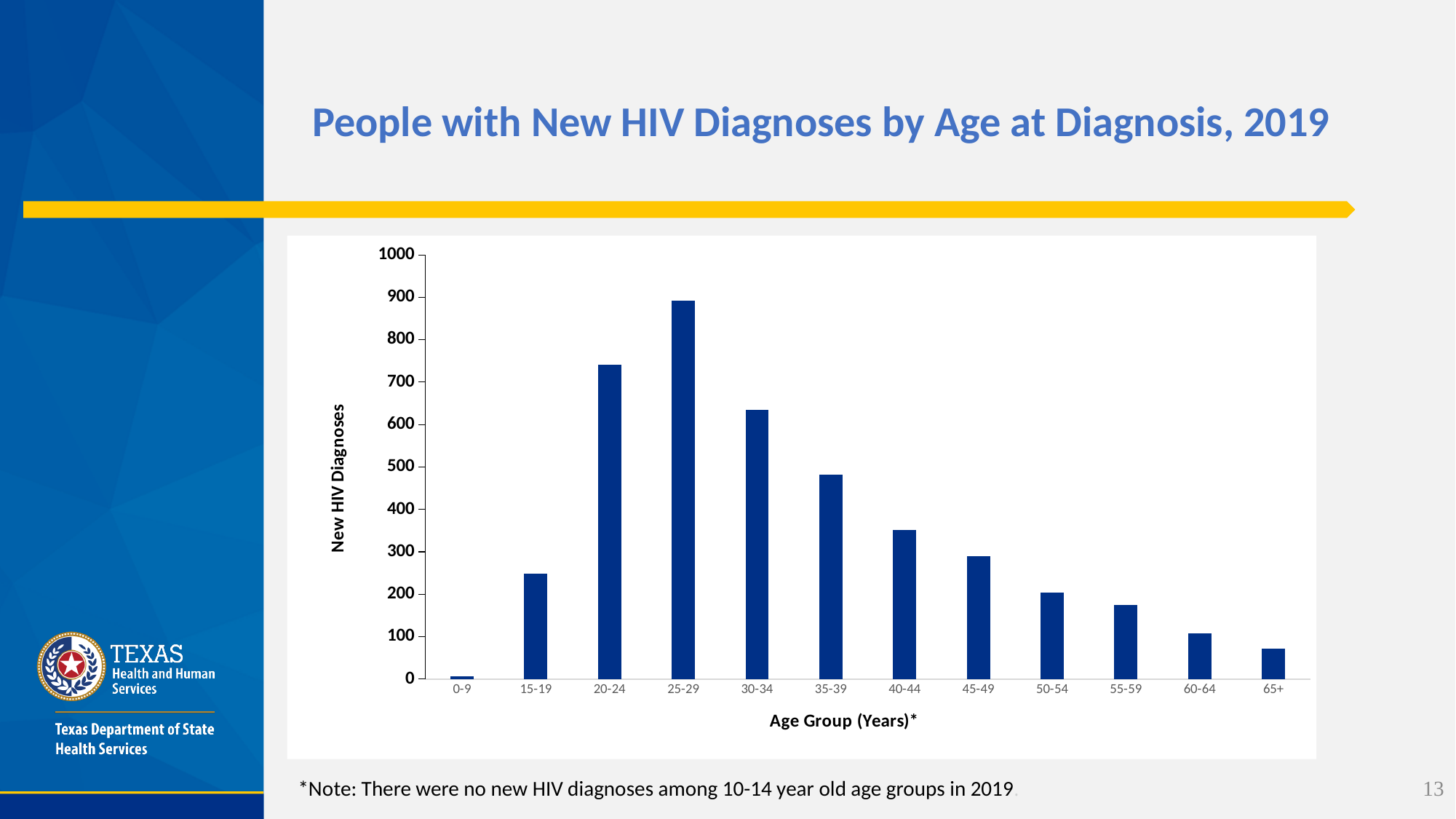
Is the value for the 25-29 age group greater or less than 800? greater Is the value for the 65+ age group greater or less than 100? less How many age groups are shown on the x axis of the chart? 12 Which age group has the lowest number of new HIV diagnoses? 0-9 What is the label of the y axis of the chart? New HIV Diagnoses Do the values rise or fall along the x axis from the 25-29 age group to the 65+ age group? Fall Is the value for the 20-24 age group greater or less than 700? greater Which age group has the highest number of new HIV diagnoses? 25-29 What type of chart is shown on the slide? Bar chart Which age group has more new HIV diagnoses, 30-34 or 40-44? 30-34